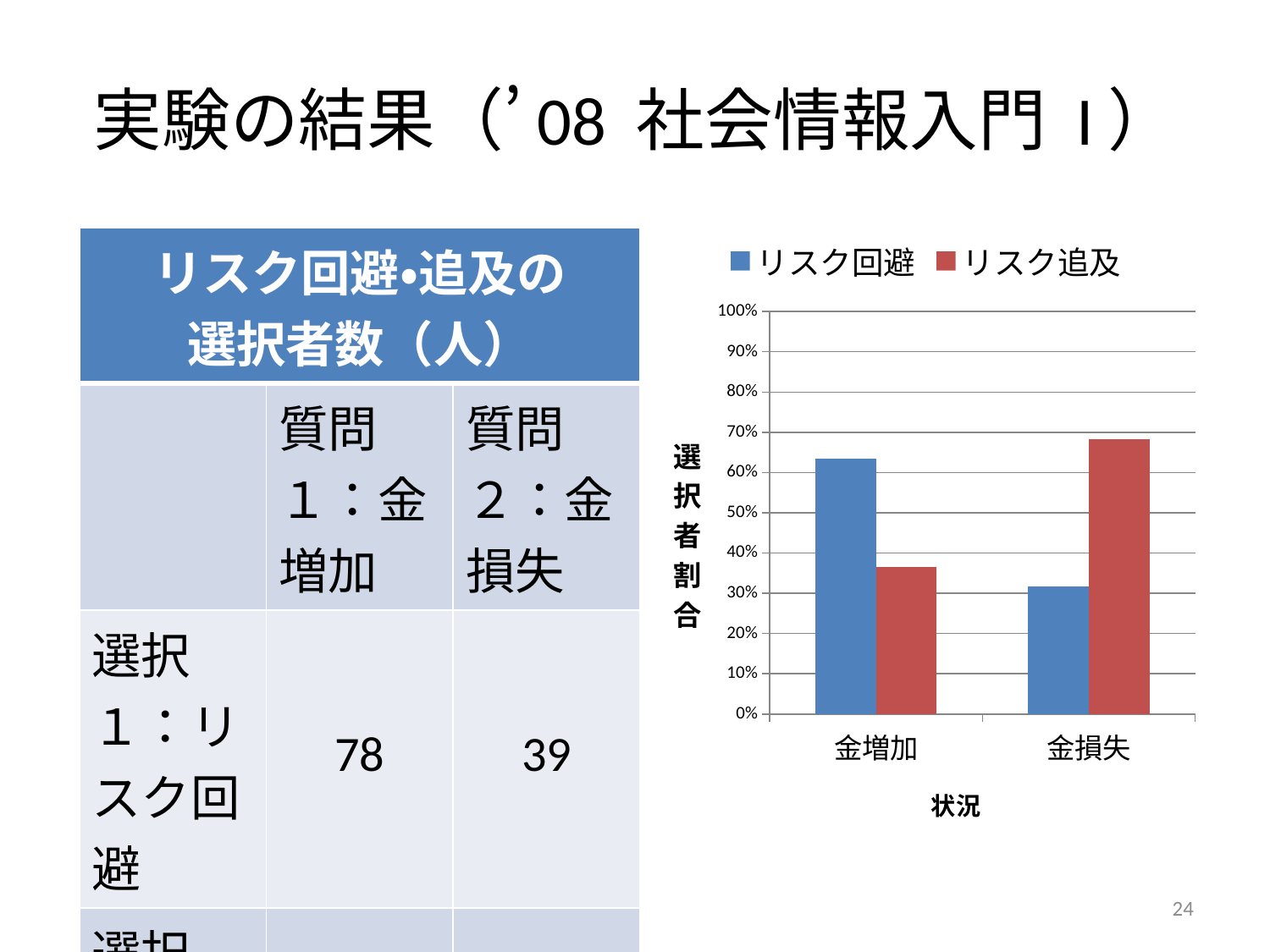
Which series is larger for 金損失, リスク回避 or リスク追及? リスク追及 Which series is larger for 金増加, リスク回避 or リスク追及? リスク回避 Is the value for リスク回避 at 金損失 greater or less than 40%? less For the リスク回避 series, does the value rise or fall from 金増加 to 金損失? fall Is the value for リスク追及 at 金損失 greater or less than 60%? greater Is the value for リスク回避 at 金増加 greater or less than 50%? greater What is the title of the x axis of the chart? 状況 How many series does the chart legend list? 2 What kind of chart is shown on the right side of the slide? bar chart How many categories are shown on the x axis of the chart? 2 For the リスク追及 series, does the value rise or fall from 金増加 to 金損失? rise